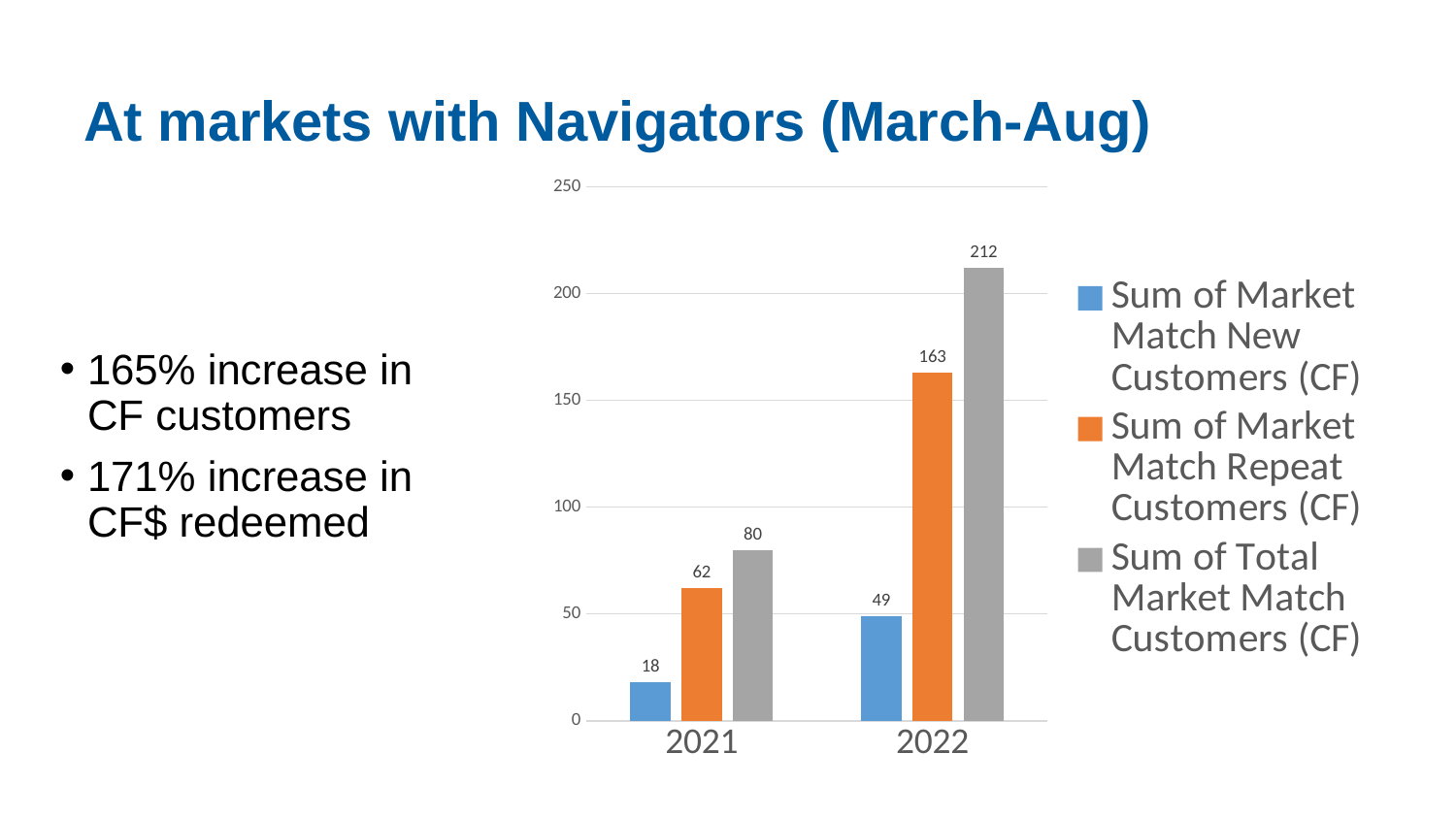
What kind of chart is shown on the slide? Bar chart Is the value for Sum of Market Match Repeat Customers (CF) in 2022 greater or less than 150? greater What is the difference between the Sum of Total Market Match Customers (CF) in 2022 and in 2021? 132 What is the value for Sum of Market Match Repeat Customers (CF) in 2021? 62 What is the value for Sum of Total Market Match Customers (CF) in 2022? 212 Is the value for Sum of Market Match New Customers (CF) in 2022 larger than the value for Sum of Market Match Repeat Customers (CF) in 2021? No Which series has the lowest value in 2022? Sum of Market Match New Customers (CF) Which year has the higher value for Sum of Total Market Match Customers (CF)? 2022 What is the value for Sum of Market Match Repeat Customers (CF) in 2022? 163 What is the value for Sum of Market Match New Customers (CF) in 2021? 18 How many series does the chart legend list? 3 How many years are shown on the x axis of the chart? 2